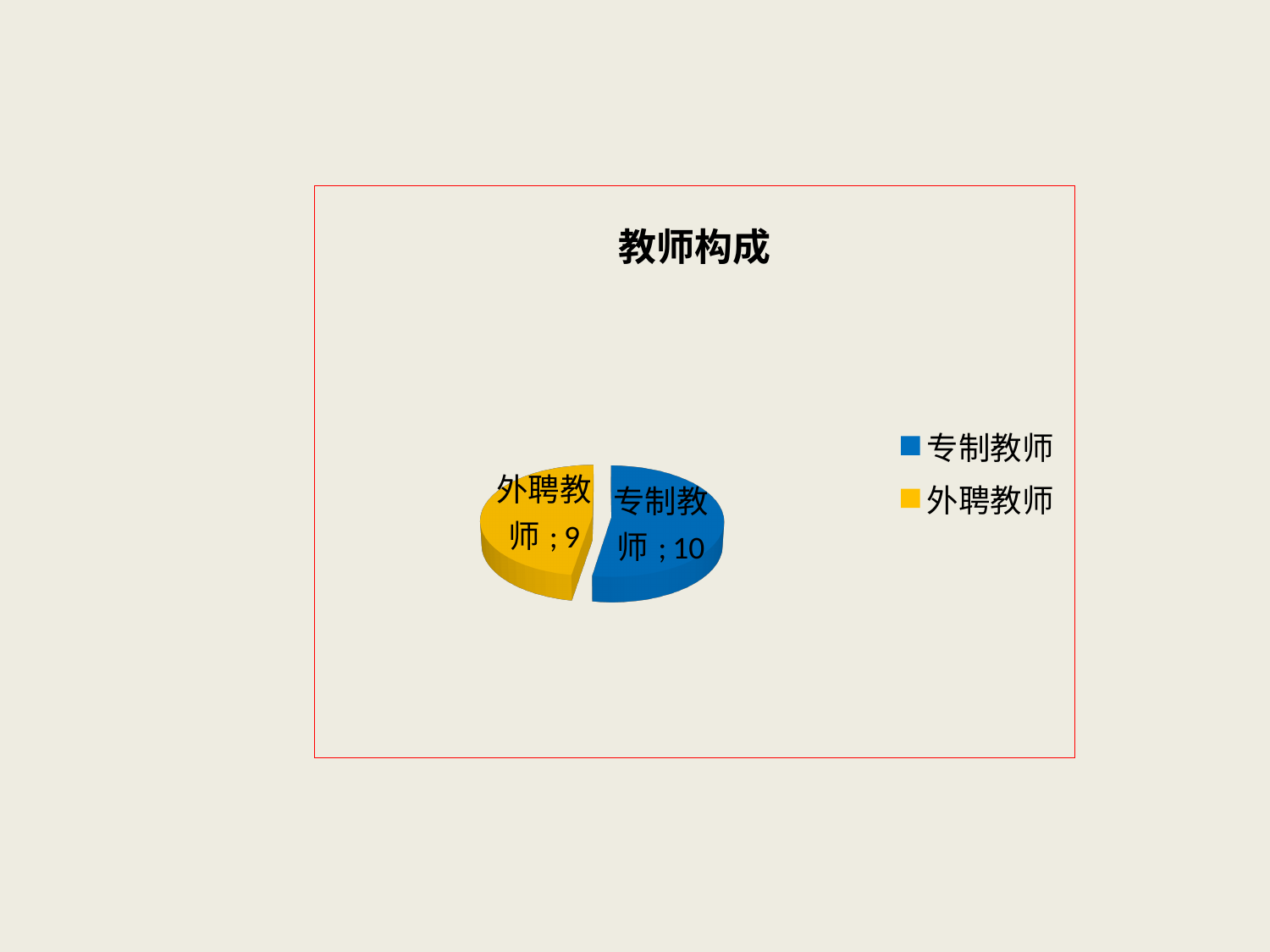
What colour is the slice for 外聘教师? Yellow What kind of chart is shown on the slide? Pie chart What is the difference between the values for 专制教师 and 外聘教师? 1 What is the value for 专制教师 in the pie chart? 10 What is the total of all slices in the pie chart? 19 How many categories are shown in the pie chart? 2 What is the title of the chart? 教师构成 Which category has the largest slice in the pie chart? 专制教师 Which is larger, the value for 专制教师 or the value for 外聘教师? 专制教师 How many entries does the legend list? 2 What is the value for 外聘教师 in the pie chart? 9 Which category has the smallest slice in the pie chart? 外聘教师